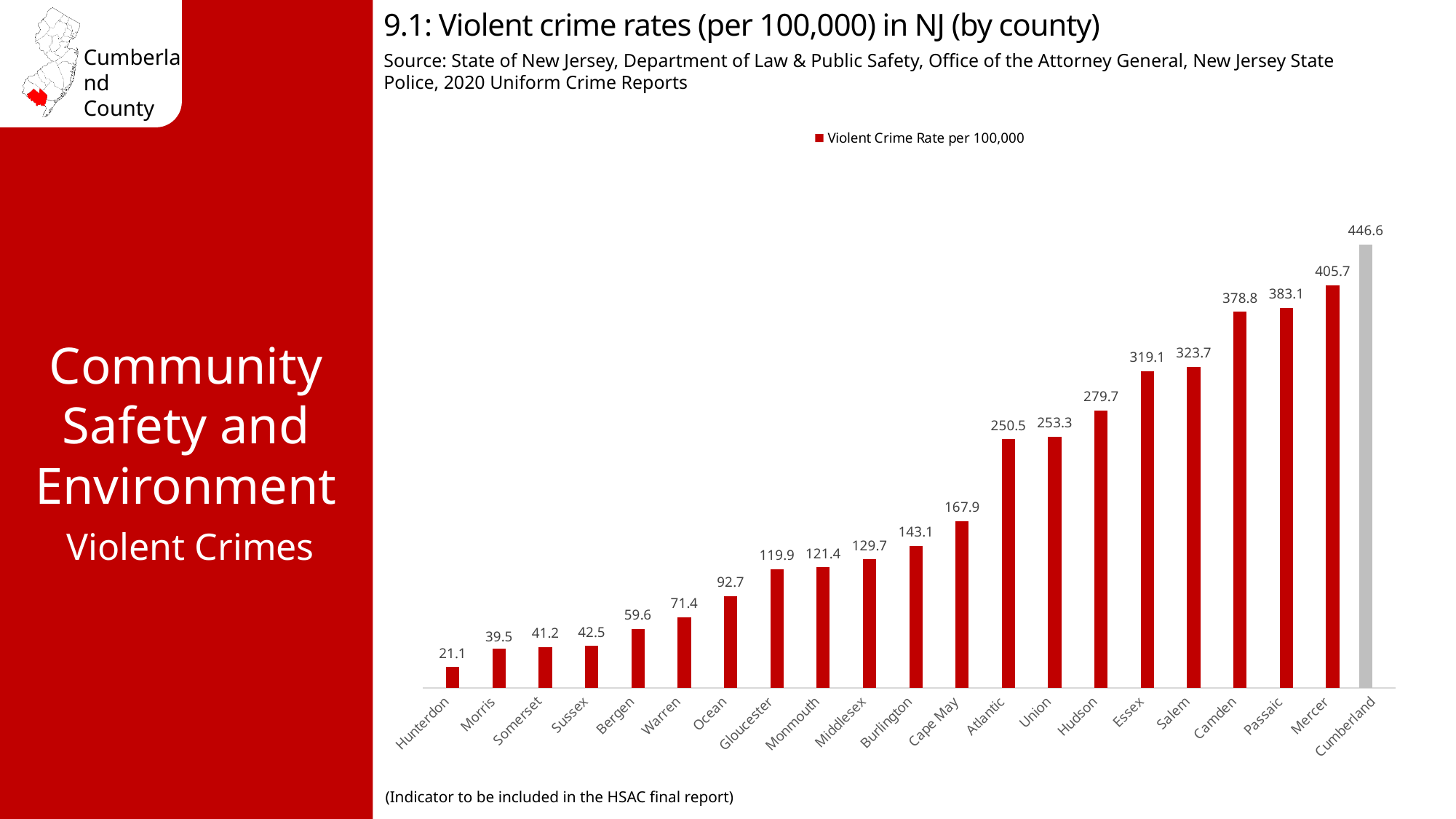
Do the violent crime rates rise or fall from left to right across the counties? Rise Which county has a higher violent crime rate, Essex or Atlantic? Essex What kind of chart is shown on the slide? Bar chart How many counties are shown on the chart? 21 How many series does the legend list? 1 What is the violent crime rate per 100,000 for Cape May County? 167.9 What is the difference between the violent crime rates of Cumberland and Hunterdon counties? 425.5 Which county has the highest violent crime rate? Cumberland What is the violent crime rate per 100,000 for Cumberland County? 446.6 Which county has the lowest violent crime rate? Hunterdon What is the difference between the violent crime rates of Cumberland and Mercer counties? 40.9 What is the violent crime rate per 100,000 for Hudson County? 279.7